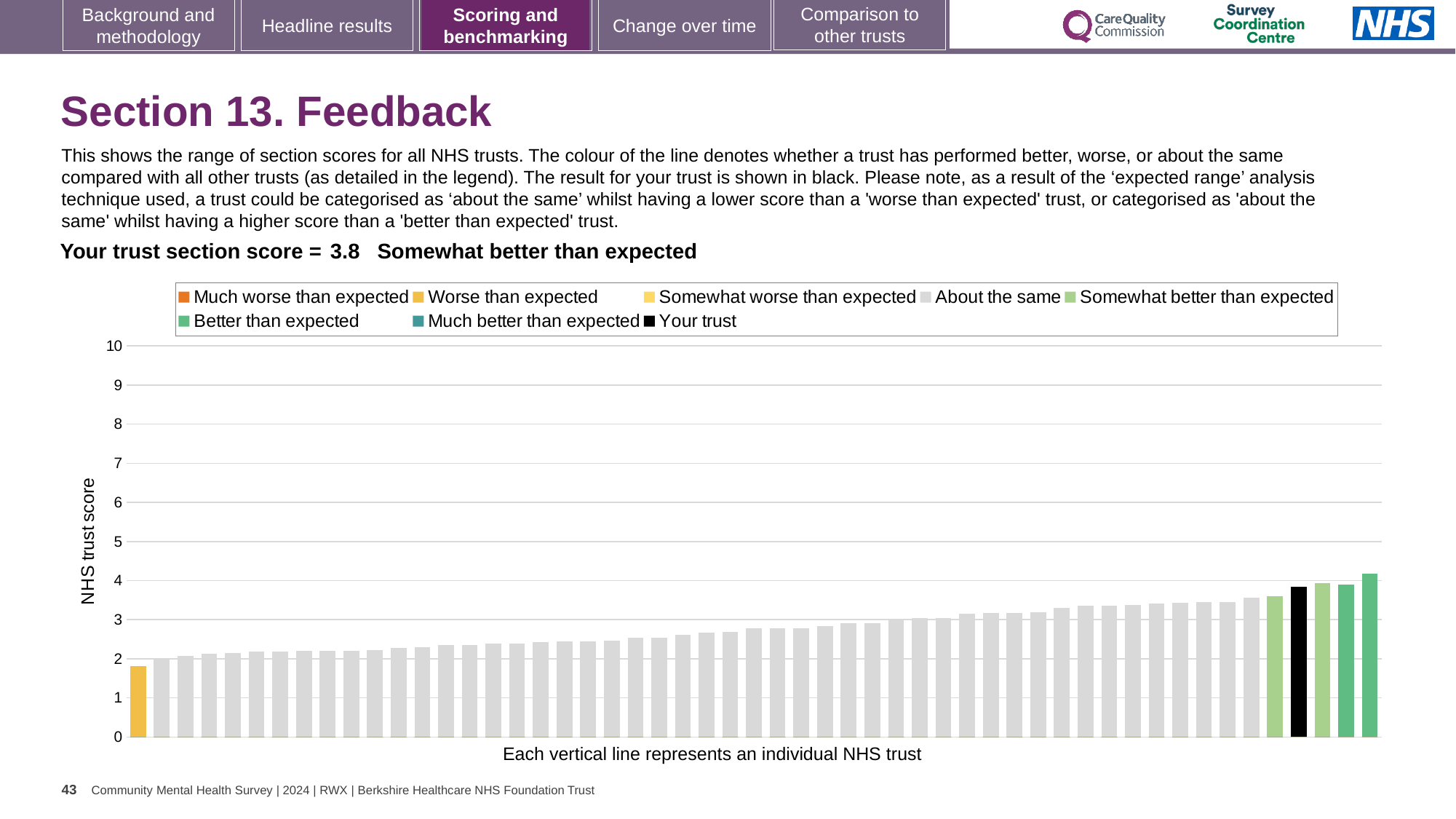
How is your trust's section score categorised according to the slide? Somewhat better than expected What is the section score for your trust shown on the slide? 3.8 Is the value of the black bar (your trust) greater or less than 4? less Is the value of the rightmost bar greater or less than 4? greater What kind of chart is shown on the slide? bar chart Is the value of the black bar (your trust) greater or less than 3? greater What colour is the bar representing your trust? black What is the highest value shown on the y axis? 10 How many entries does the chart legend list? 8 What is the label of the y axis? NHS trust score Do the bar values rise or fall from left to right along the x axis? rise